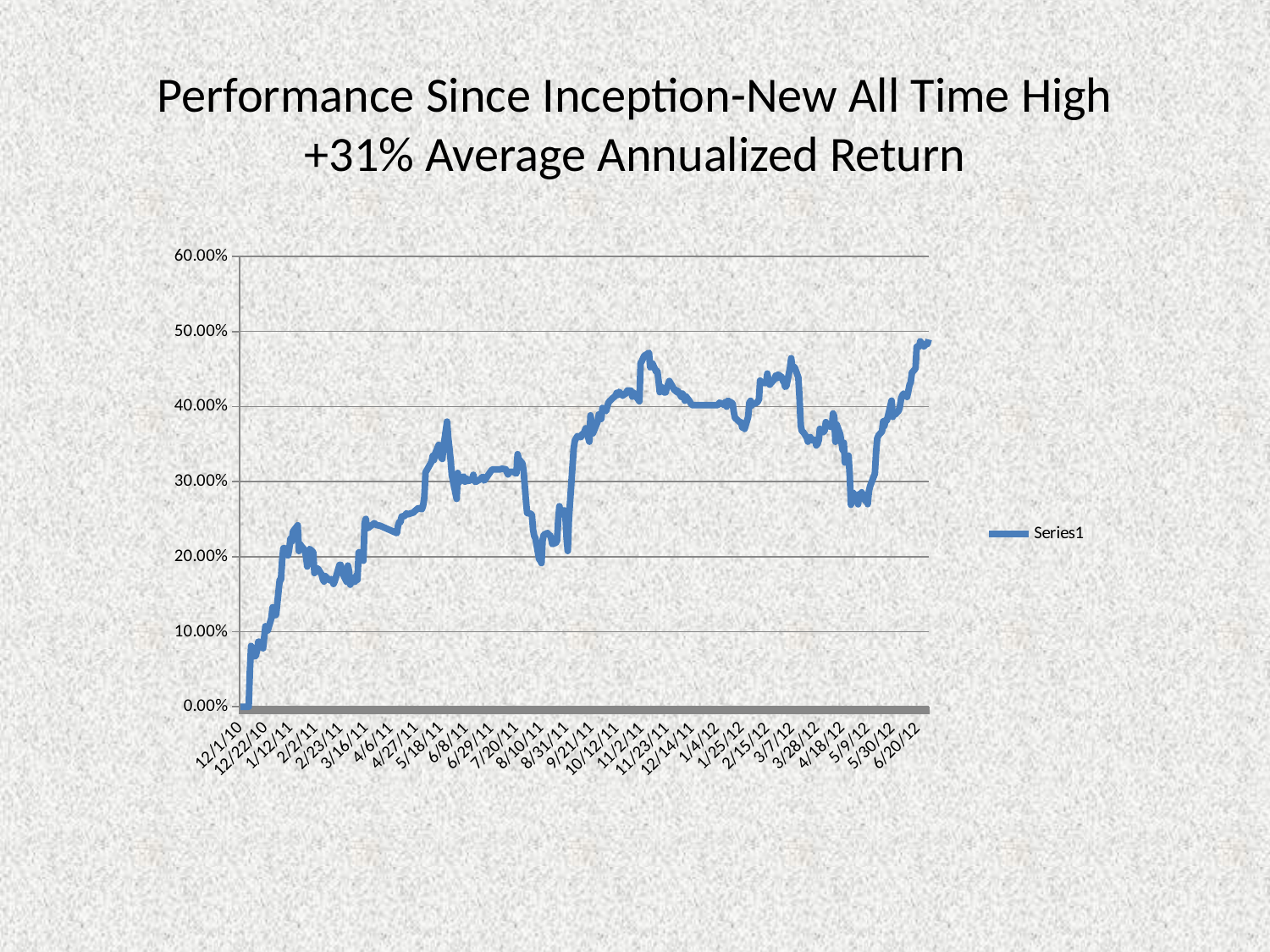
How many series does the legend list? 1 What kind of chart is shown on the slide? line chart What is the highest value shown on the vertical axis? 60.00% Is the value for 8/10/11 greater or less than 30%? less Is the value for 6/20/12 greater or less than 40%? greater How many date labels are shown on the horizontal axis? 28 Overall, does the line rise or fall from 12/1/10 to 6/20/12? rise Is the value for 11/2/11 greater or less than 40%? greater What is the value of the line at the first date, 12/1/10? 0.00% What is the name of the series shown in the legend? Series1